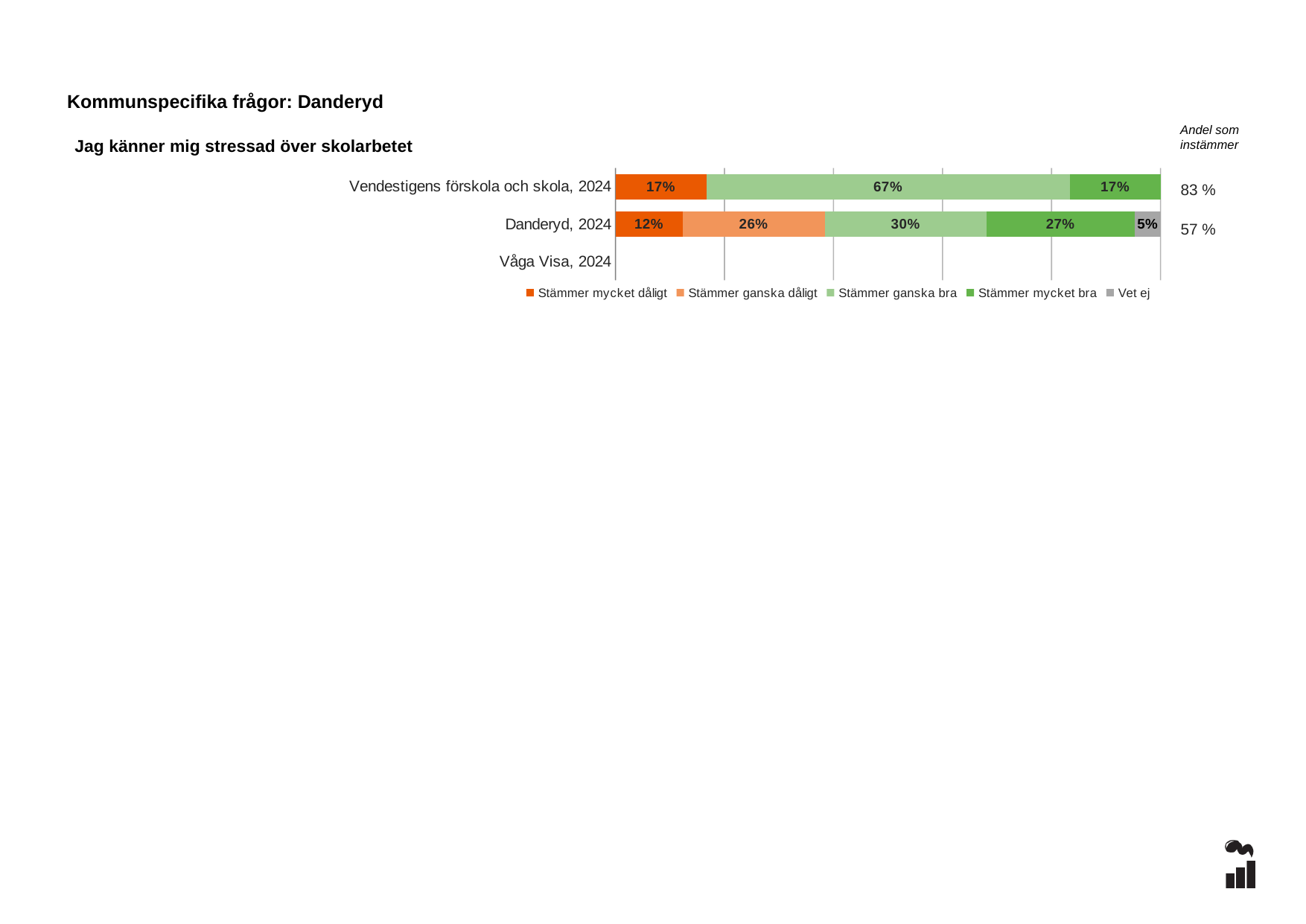
Which response category has the largest share for Danderyd, 2024? Stämmer ganska bra Which has a larger "Stämmer mycket bra" share: Vendestigens förskola och skola, 2024 or Danderyd, 2024? Danderyd, 2024 How many series does the legend list? 5 How many category rows are shown on the chart's vertical axis? 3 What is the difference between the "Stämmer mycket dåligt" shares for Vendestigens förskola och skola, 2024 and Danderyd, 2024? 5 percentage points What is the "Vet ej" share for Danderyd, 2024? 5% What percentage of respondents at Vendestigens förskola och skola, 2024 answered "Stämmer ganska bra"? 67% Which category row on the chart has no bar plotted? Våga Visa, 2024 What is the "Andel som instämmer" value shown for Vendestigens förskola och skola, 2024? 83 % What kind of chart is shown on the slide? Stacked bar chart What is the "Andel som instämmer" value shown for Danderyd, 2024? 57 % What percentage of respondents for Danderyd, 2024 answered "Stämmer ganska dåligt"? 26%